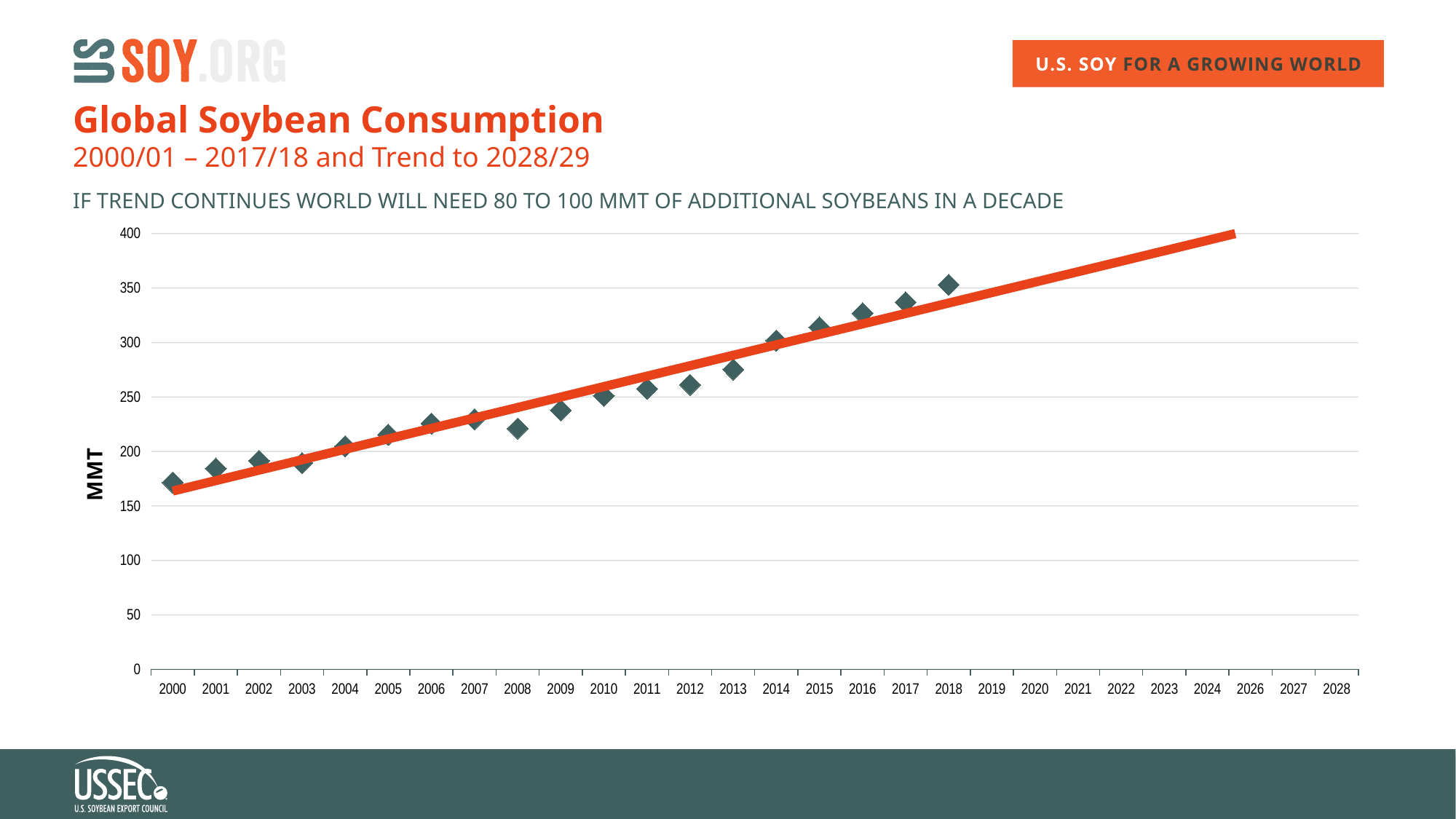
Is the plotted value for 2000 greater or less than 200? less Is the plotted value for 2008 greater or less than 200? greater How many years have plotted data points on the chart? 19 Is the plotted value for 2018 greater or less than 300? greater What is the label on the vertical axis of the chart? MMT Which year has the larger plotted value, 2005 or 2015? 2015 Which year has the lowest plotted soybean consumption value? 2000 Which year has the highest plotted soybean consumption value? 2018 What kind of chart is shown on the slide? Scatter chart with a trend line Do the plotted soybean consumption values rise or fall from 2000 to 2018? Rise